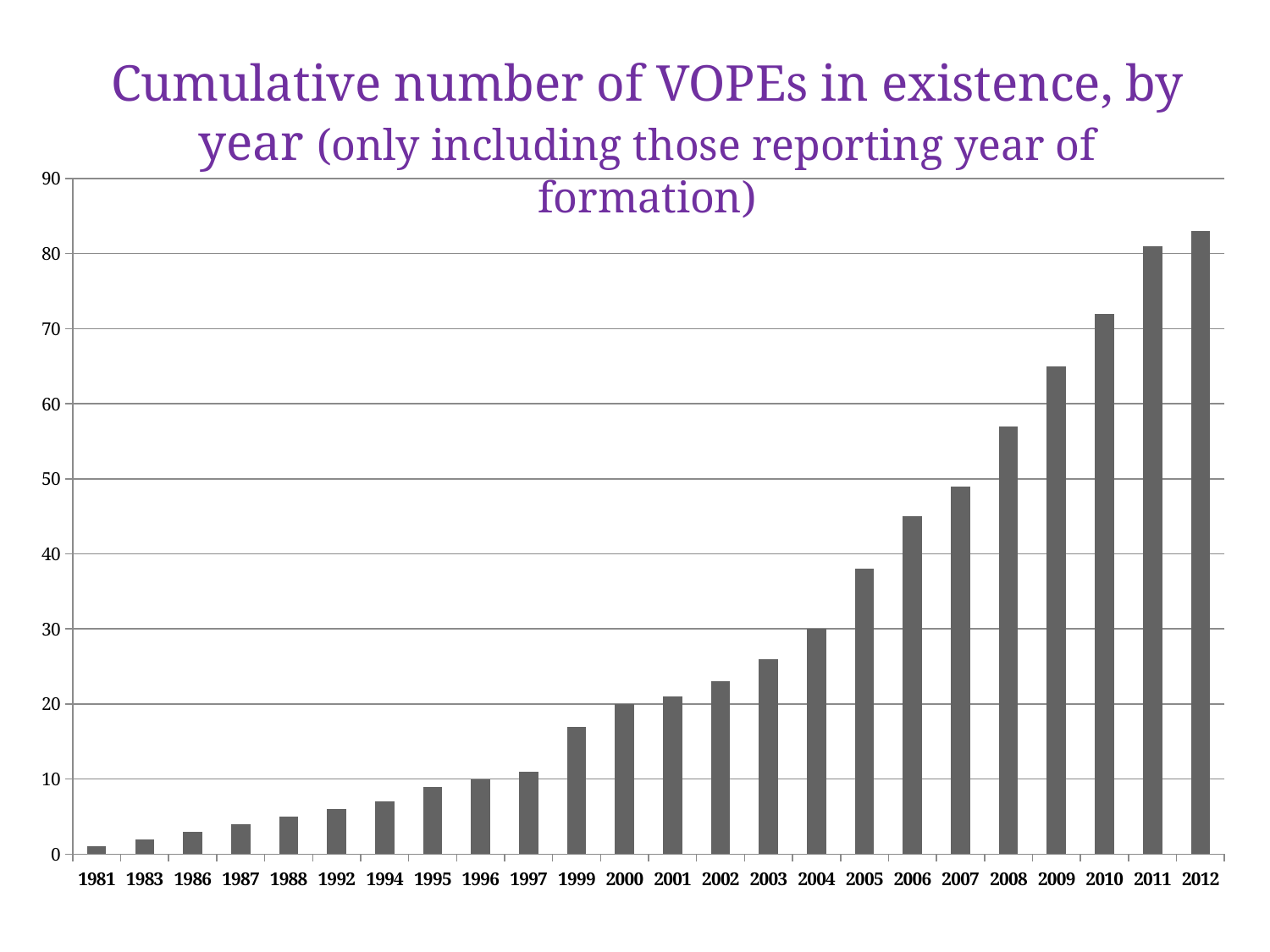
Do the values rise or fall as the years progress along the x axis? rise How many years (categories) are shown on the x axis? 24 Is the value for 2010 greater or less than 70? greater What is the title of the chart? Cumulative number of VOPEs in existence, by year (only including those reporting year of formation) Is the value for 2005 greater or less than 40? less Which year has the lowest cumulative number of VOPEs? 1981 What kind of chart is shown on the slide? bar chart Which year has the highest cumulative number of VOPEs? 2012 Is the value for 2008 greater or less than 60? less Which is larger, the value for 2009 or the value for 2007? 2009